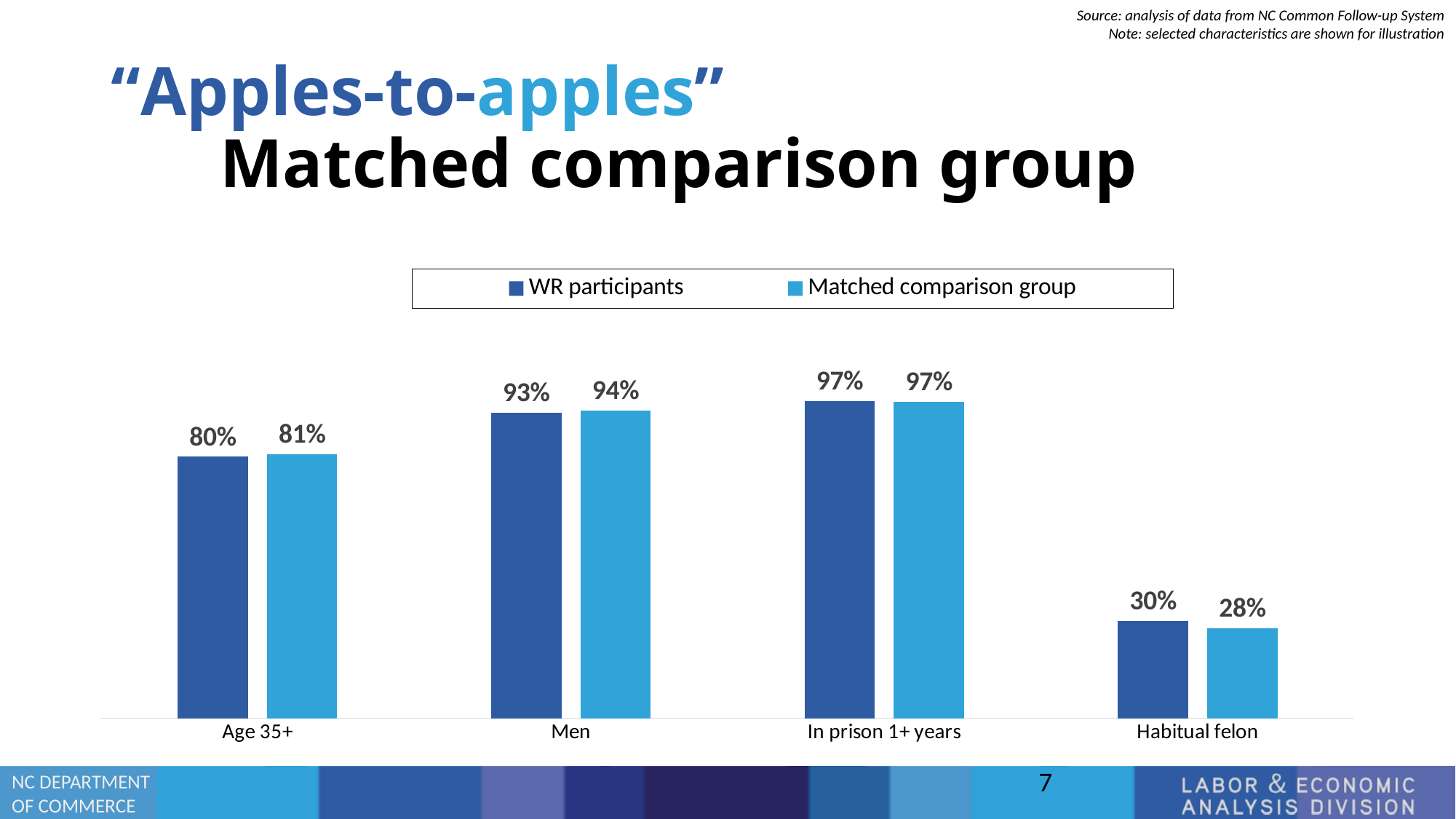
Which category has the highest value for the Matched comparison group? In prison 1+ years What is the difference between WR participants and the Matched comparison group in the Habitual felon category? 2% Which series is shown in the lighter blue colour? Matched comparison group What is the value for WR participants in the Age 35+ category? 80% What is the difference between the WR participants values for Men and Age 35+? 13% How many categories are shown on the x axis? 4 What kind of chart is shown on the slide? Bar chart What is the value for the Matched comparison group in the Men category? 94% In the Habitual felon category, which is larger: WR participants or the Matched comparison group? WR participants Which category has the lowest value for WR participants? Habitual felon How many series does the legend list? 2 What is the value for the Matched comparison group in the Habitual felon category? 28%